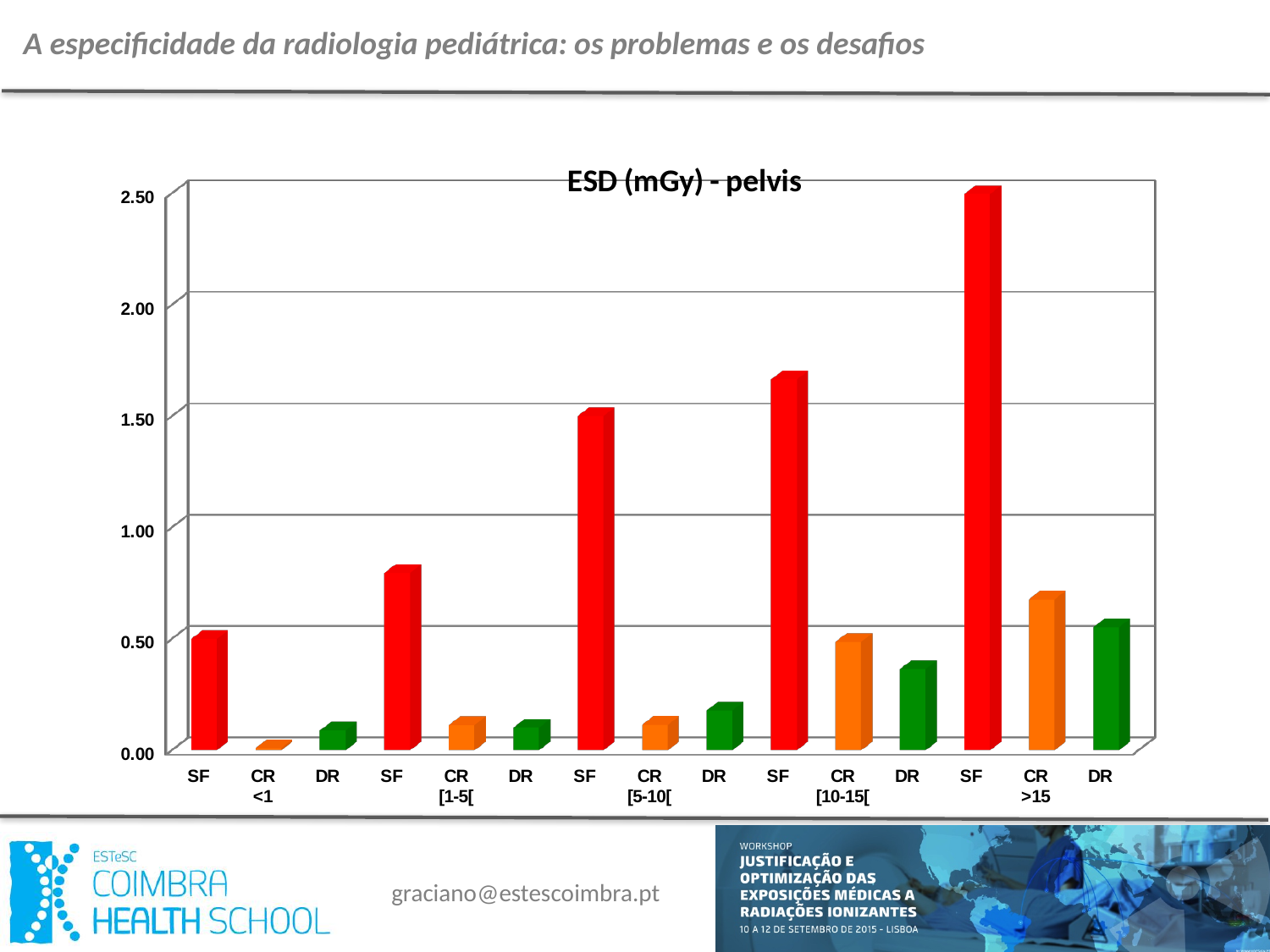
Which bar has the lowest value in the chart? CR <1 Is the value for SF in the [1-5[ group greater or less than 1.00? less How many bars are plotted in the chart? 15 How many age groups are shown along the x axis of the chart? 5 Do the SF values rise or fall as the age groups go from <1 to >15? rise Is the value for DR in the [10-15[ group greater or less than 0.50? less Is the value for SF in the [5-10[ group greater or less than 1.00? greater Which bar has the highest value in the chart? SF >15 What kind of chart is shown on the slide? bar chart Which is larger, SF in the [5-10[ group or SF in the [10-15[ group? SF in the [10-15[ group What is the title of the chart? ESD (mGy) - pelvis